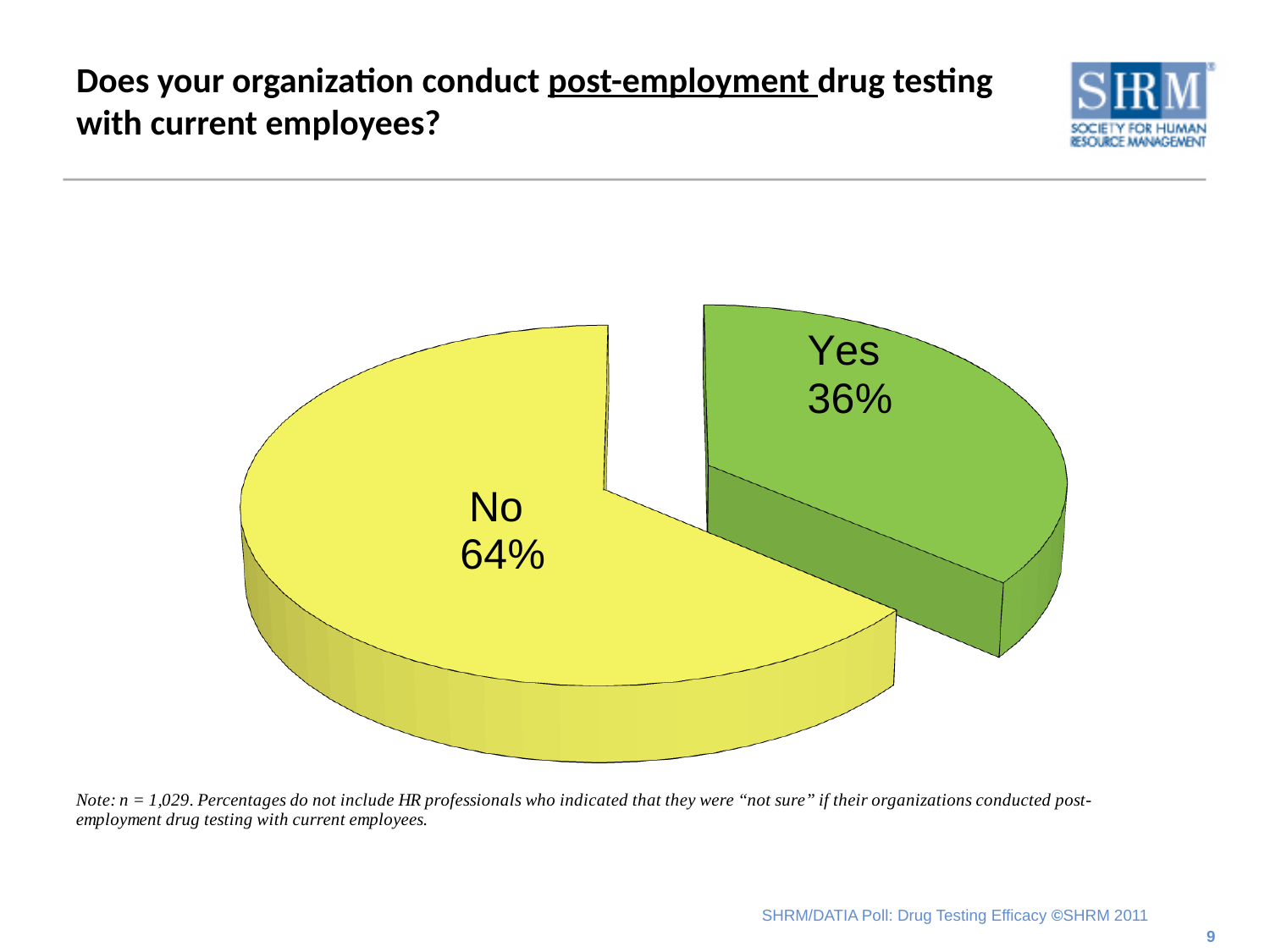
What is the sample size (n) given in the note below the chart? 1,029 What percentage of respondents answered "Yes"? 36% Is the "Yes" slice larger or smaller than the "No" slice? smaller What share of the pie does the "No" slice represent? 64% What percentage of respondents answered "No"? 64% Which response has the larger share of the pie? No What colour is the "Yes" slice? green What kind of chart is shown on the slide? pie chart What is the difference in percentage points between the "No" and "Yes" slices? 28 Which response has the smaller share of the pie? Yes How many slices does the pie chart have? 2